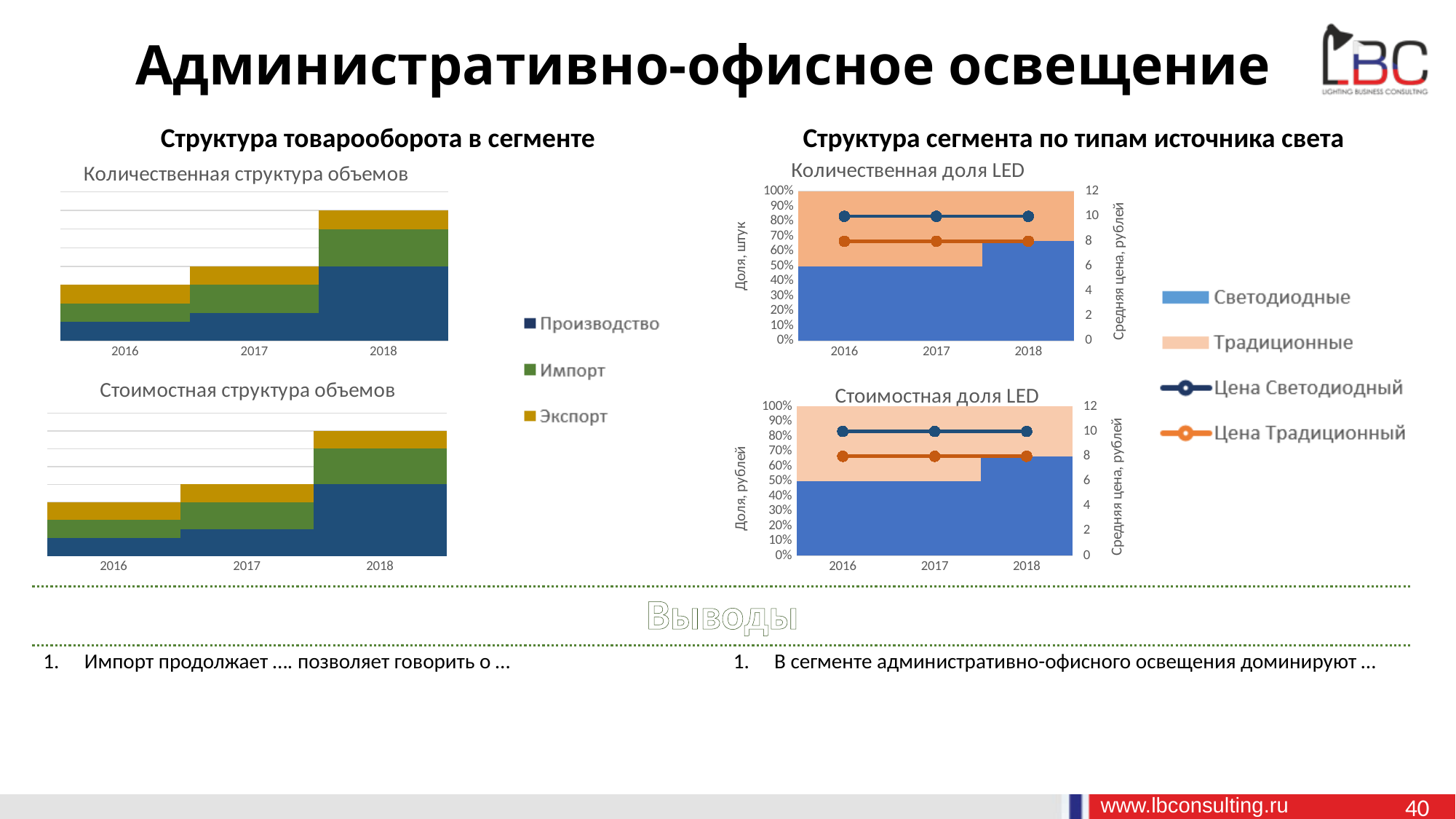
In the chart titled "Стоимостная структура объемов", which year has the shortest stacked bar? 2016 In the chart titled "Количественная структура объемов", which year has the tallest stacked bar? 2018 How many series does the legend shared by the two left-hand charts list? 3 In the chart titled "Количественная доля LED", what is the value of "Цена Светодиодный" in 2017 on the right axis? 10 What kind of chart is "Количественная структура объемов"? stacked bar chart In the chart titled "Стоимостная структура объемов", do the total bar heights rise or fall from 2016 to 2018? rise In the chart titled "Количественная структура объемов", how many categories are shown on the x axis? 3 In the chart titled "Стоимостная доля LED", is the share of "Светодиодные" in 2016 greater or less than 60%? less How many series does the legend for the right-hand charts list? 4 In the chart titled "Стоимостная доля LED", what is the value of "Цена Традиционный" in 2018 on the right axis? 8 In the chart titled "Количественная доля LED", which price line is higher, "Цена Светодиодный" or "Цена Традиционный"? Цена Светодиодный